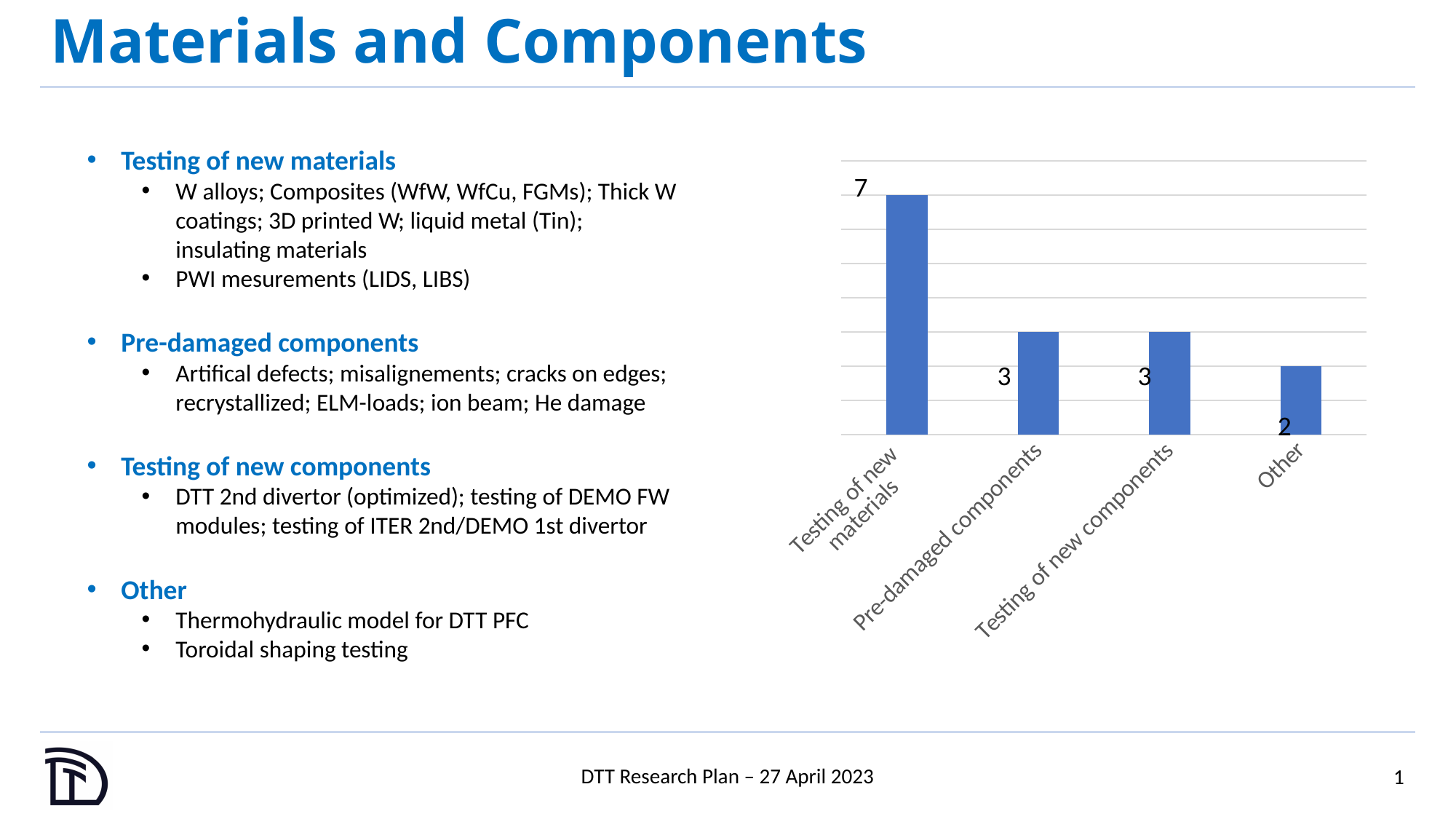
Which is larger, the value for Pre-damaged components or the value for Other? Pre-damaged components What is the value for Testing of new materials? 7 What is the value for Testing of new components? 3 What kind of chart is shown on the slide? Bar chart What is the value for Other? 2 How many categories are shown in the chart? 4 Which category has the highest value? Testing of new materials What is the difference between the values for Testing of new materials and Pre-damaged components? 4 What colour are the bars in the chart? Blue What is the difference between the values for Testing of new materials and Other? 5 Which category has the lowest value? Other What is the value for Pre-damaged components? 3